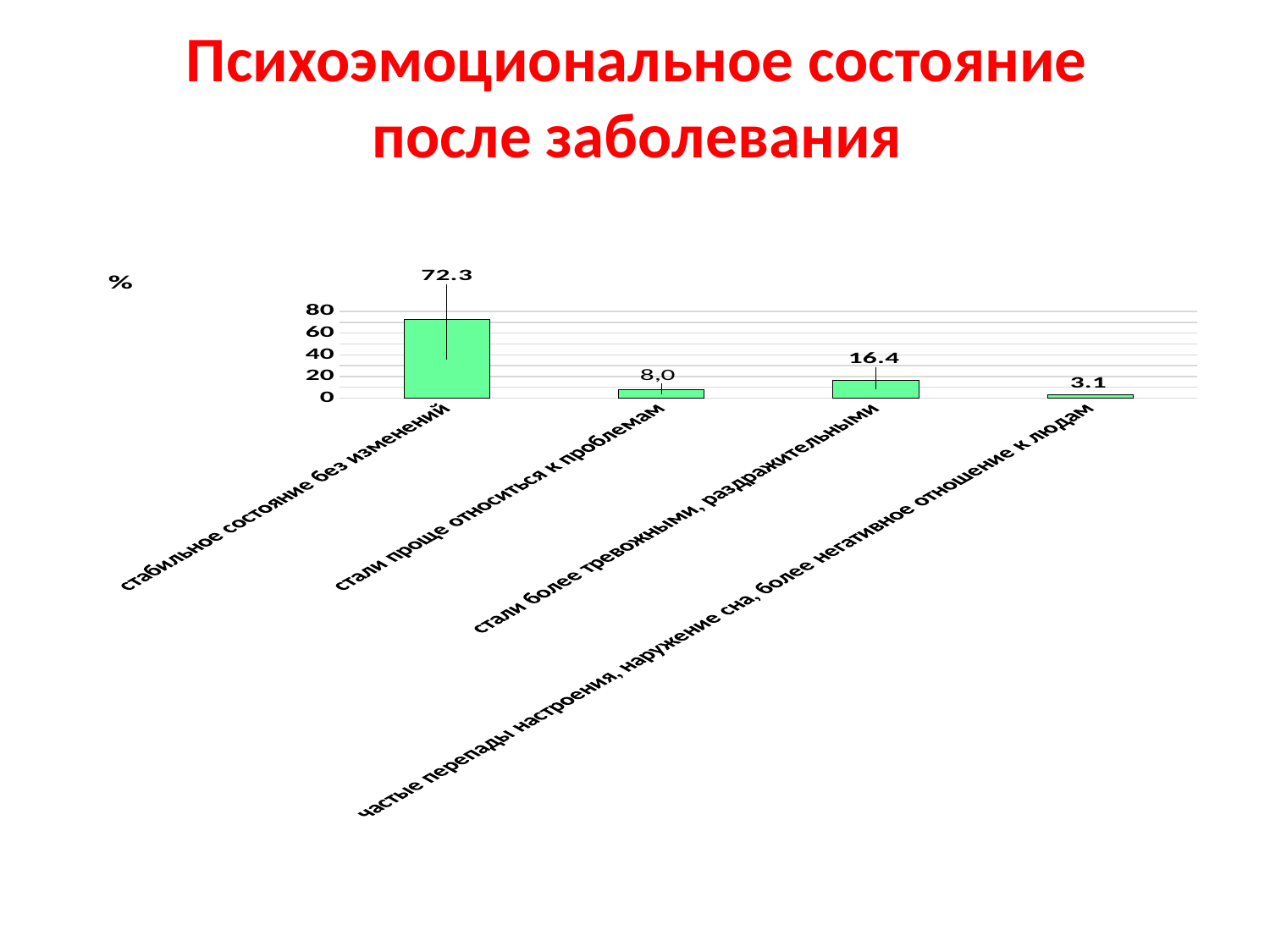
Which category has the lowest value? частые перепады настроения, наружение сна, более негативное отношение к людам What is the value for "стали проще относиться к проблемам"? 8,0 Which category has the highest value? стабильное состояние без изменений How many categories are shown in the chart? 4 What is the value for "стали более тревожными, раздражительными"? 16.4 Which is larger: the value for "стали более тревожными, раздражительными" or the value for "стали проще относиться к проблемам"? стали более тревожными, раздражительными What is the value for "частые перепады настроения, нарушение сна, более негативное отношение к людям"? 3.1 What is the difference between the values for "стабильное состояние без изменений" and "стали более тревожными, раздражительными"? 55.9 What is the value for "стабильное состояние без изменений"? 72.3 What kind of chart is shown on the slide? bar chart What unit is indicated on the vertical axis of the chart? % What is the difference between the values for "стали более тревожными, раздражительными" and "стали проще относиться к проблемам"? 8.4